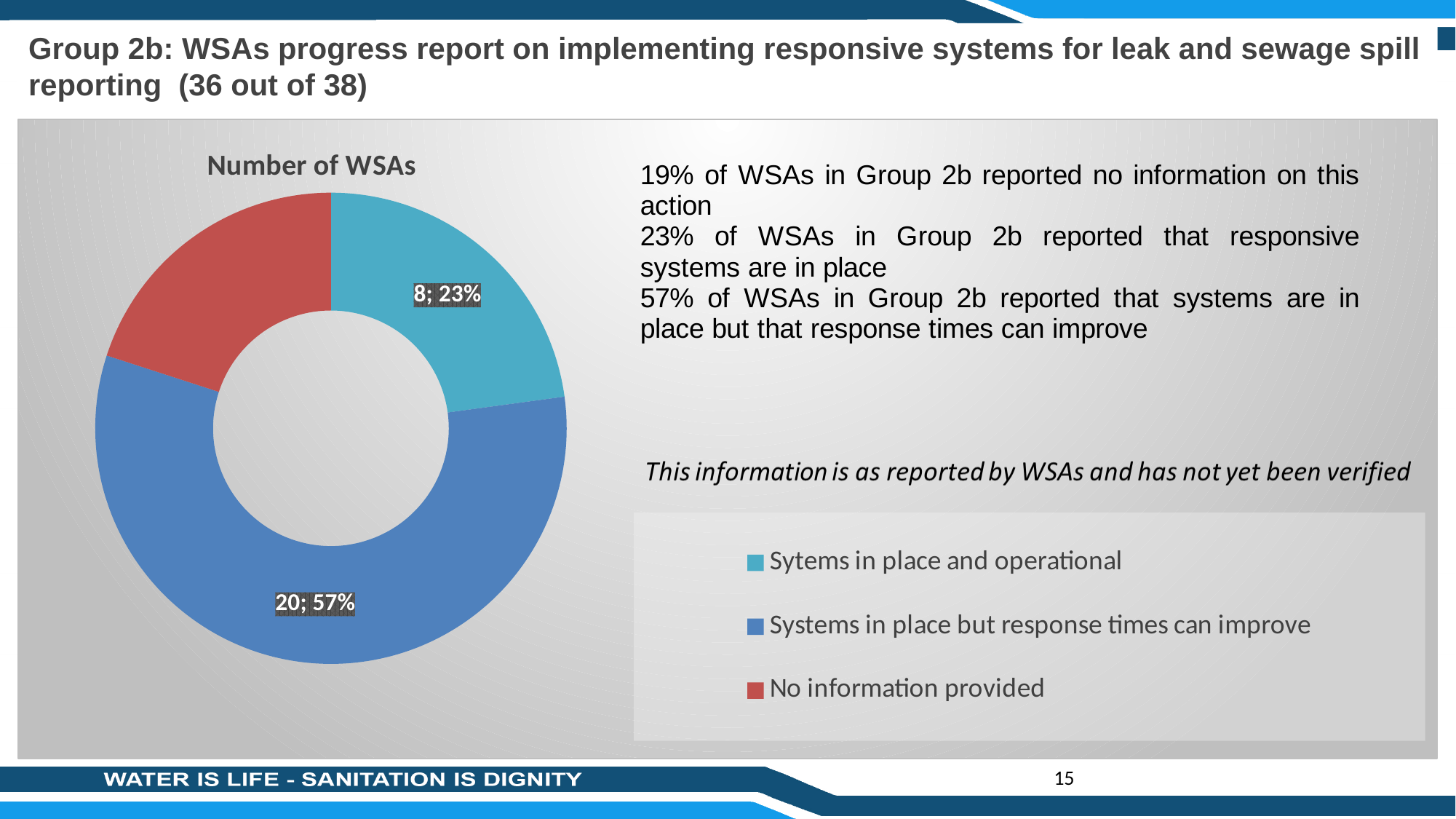
What share of the chart does 'Sytems in place and operational' represent? 23% What is the title of the chart? Number of WSAs What share of the chart does 'Systems in place but response times can improve' represent? 57% How many entries does the legend list? 3 Which is larger: 'Systems in place but response times can improve' or 'Sytems in place and operational'? Systems in place but response times can improve What is the difference in the number of WSAs between 'Systems in place but response times can improve' and 'Sytems in place and operational'? 12 How many categories (slices) does the chart have? 3 How many WSAs are in the 'Sytems in place and operational' category? 8 How many WSAs are in the 'Systems in place but response times can improve' category? 20 What colour represents 'No information provided' in the chart? red Which category has the largest slice in the chart? Systems in place but response times can improve What kind of chart is shown on the slide? doughnut (pie) chart